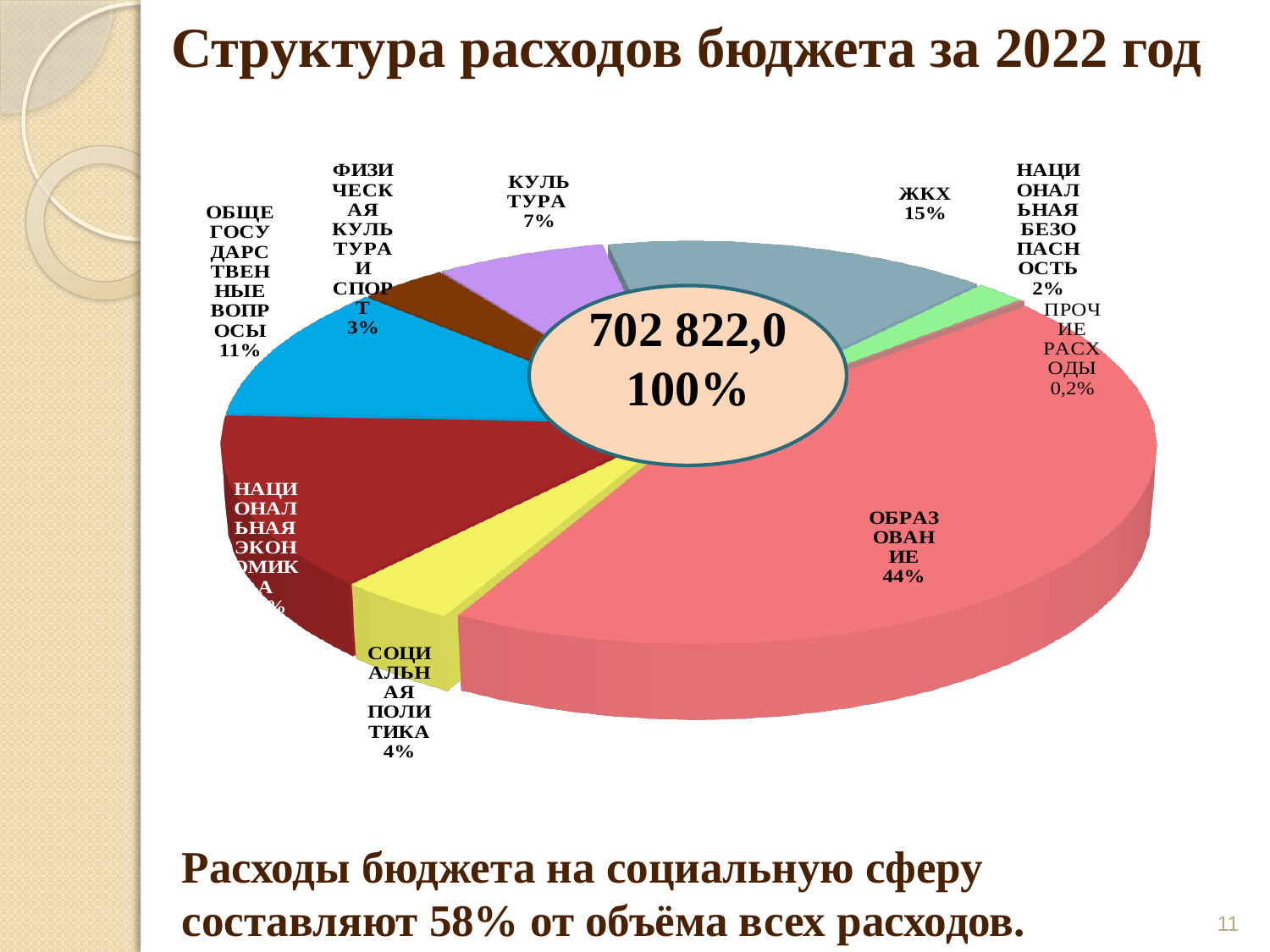
What share of budget expenditures does ОБРАЗОВАНИЕ account for? 44% What percentage is shown for КУЛЬТУРА? 7% Which category has the largest share of the pie? ОБРАЗОВАНИЕ Which category has the smallest share of the pie? ПРОЧИЕ РАСХОДЫ What percentage is shown for ЖКХ? 15% Which has a larger share, КУЛЬТУРА or ФИЗИЧЕСКАЯ КУЛЬТУРА И СПОРТ? КУЛЬТУРА What percentage is shown for ПРОЧИЕ РАСХОДЫ? 0,2% What total value is shown in the centre of the pie chart? 702 822,0 What percentage is shown for ОБЩЕГОСУДАРСТВЕННЫЕ ВОПРОСЫ? 11% By how many percentage points does ОБРАЗОВАНИЕ exceed ЖКХ? 29 What kind of chart is shown on the slide? pie chart What percentage is shown for СОЦИАЛЬНАЯ ПОЛИТИКА? 4%